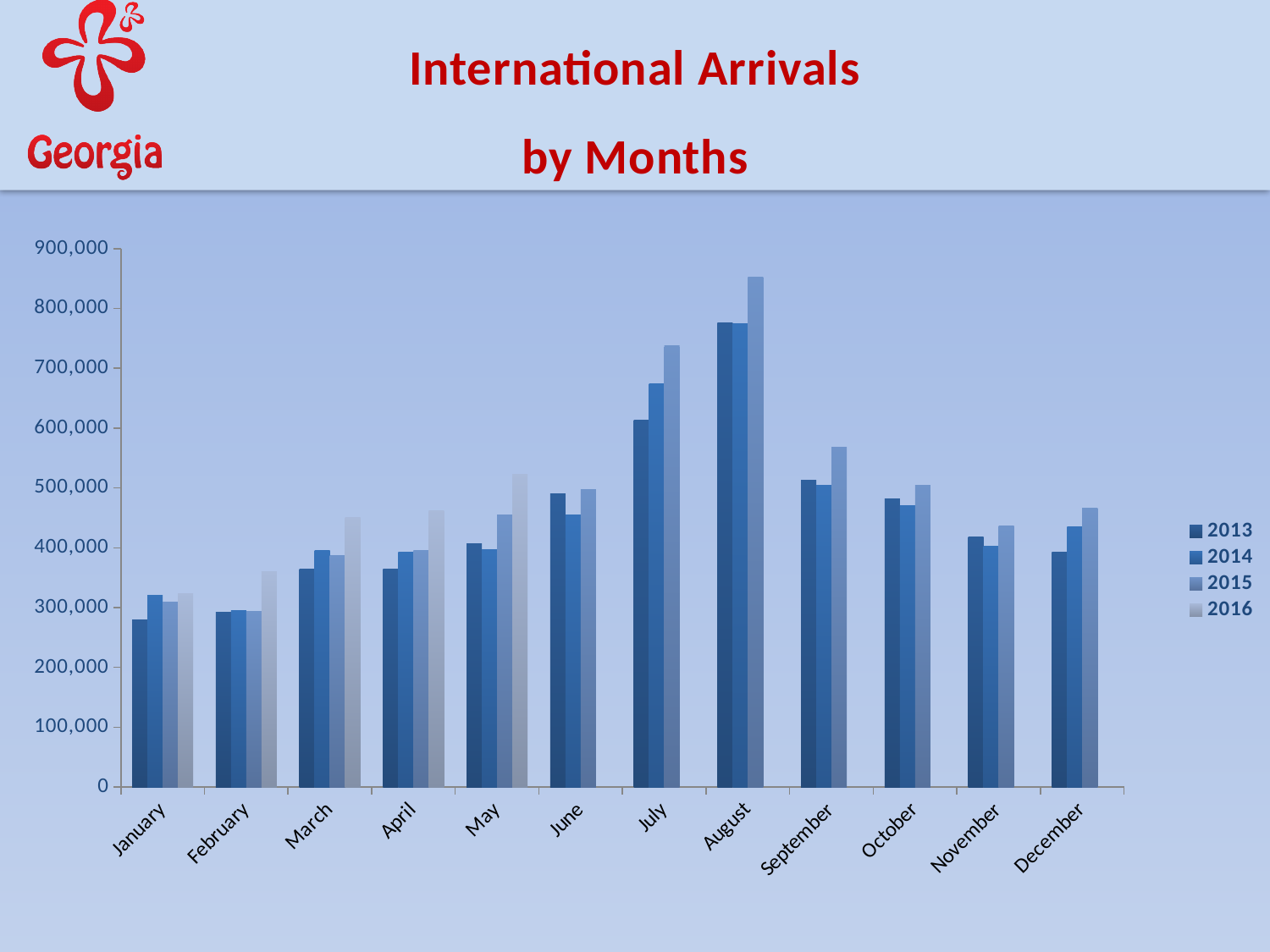
Which month has the lowest value for 2013? January Is the value for 2013 in January greater or less than 300,000? less How many series does the legend list? 4 Do the values for 2015 rise or fall from August to November? fall What kind of chart is shown on the slide? bar chart Which month has the highest value for 2015? August Is the value for 2015 in August greater or less than 800,000? greater Is the value for 2016 in May greater or less than 500,000? greater In May, which year has the larger value, 2013 or 2016? 2016 How many months are shown on the x axis? 12 Which year in the legend has bars only for January through May? 2016 In July, which year has the larger value, 2013 or 2015? 2015